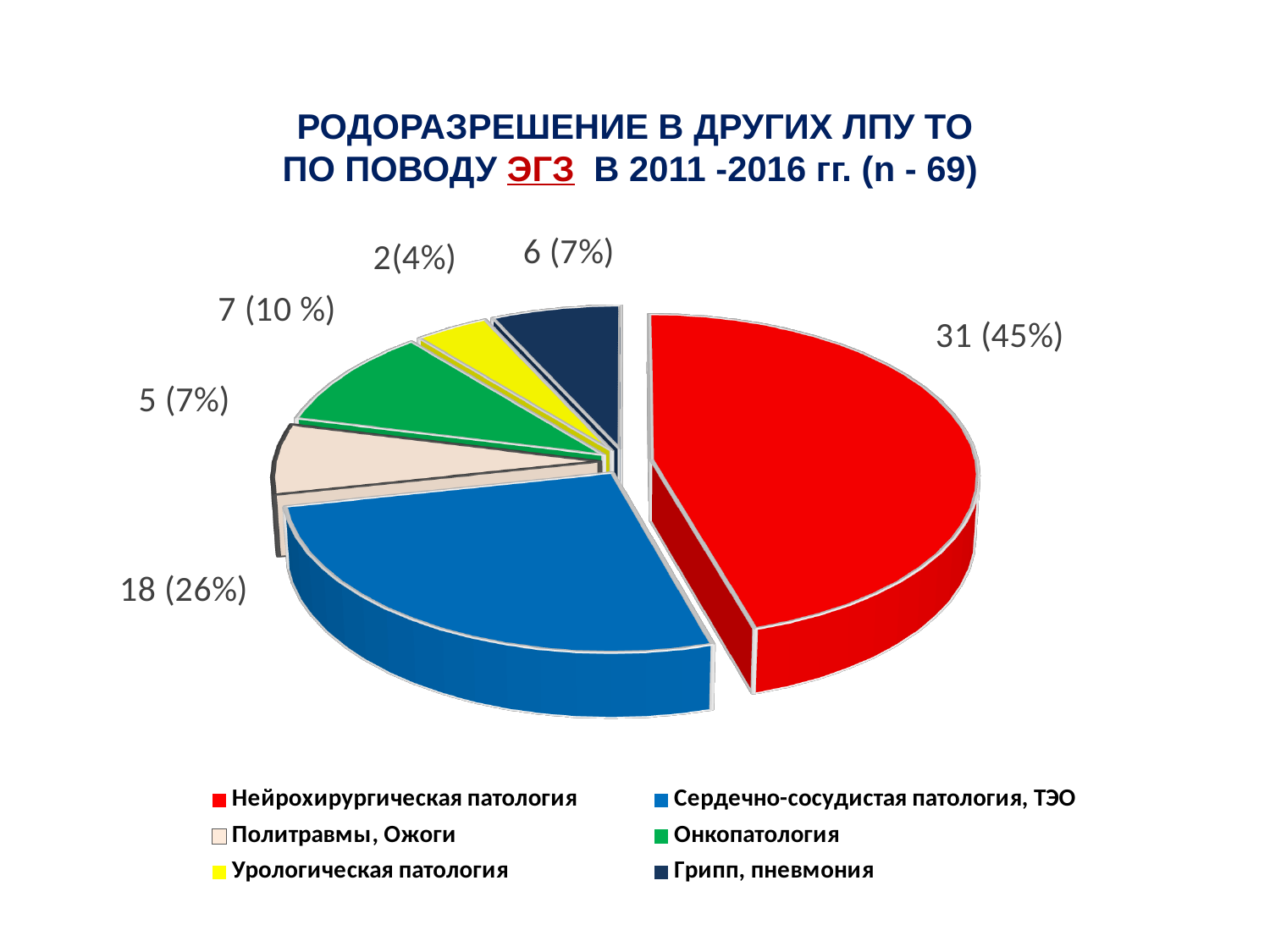
What is the value shown for Нейрохирургическая патология? 31 (45%) How many entries does the legend list? 6 Which colour represents Грипп, пневмония in the chart? dark blue What type of chart is shown on the slide? pie chart What is the difference in count between Нейрохирургическая патология and Сердечно-сосудистая патология, ТЭО? 13 What is the value shown for Сердечно-сосудистая патология, ТЭО? 18 (26%) What is the value shown for Онкопатология? 7 (10 %) Which category has the smallest slice of the pie? Урологическая патология How many slices does the pie chart have? 6 What share of the pie does Политравмы, Ожоги represent? 7% What is the value shown for Урологическая патология? 2(4%) Which category has the largest slice of the pie? Нейрохирургическая патология